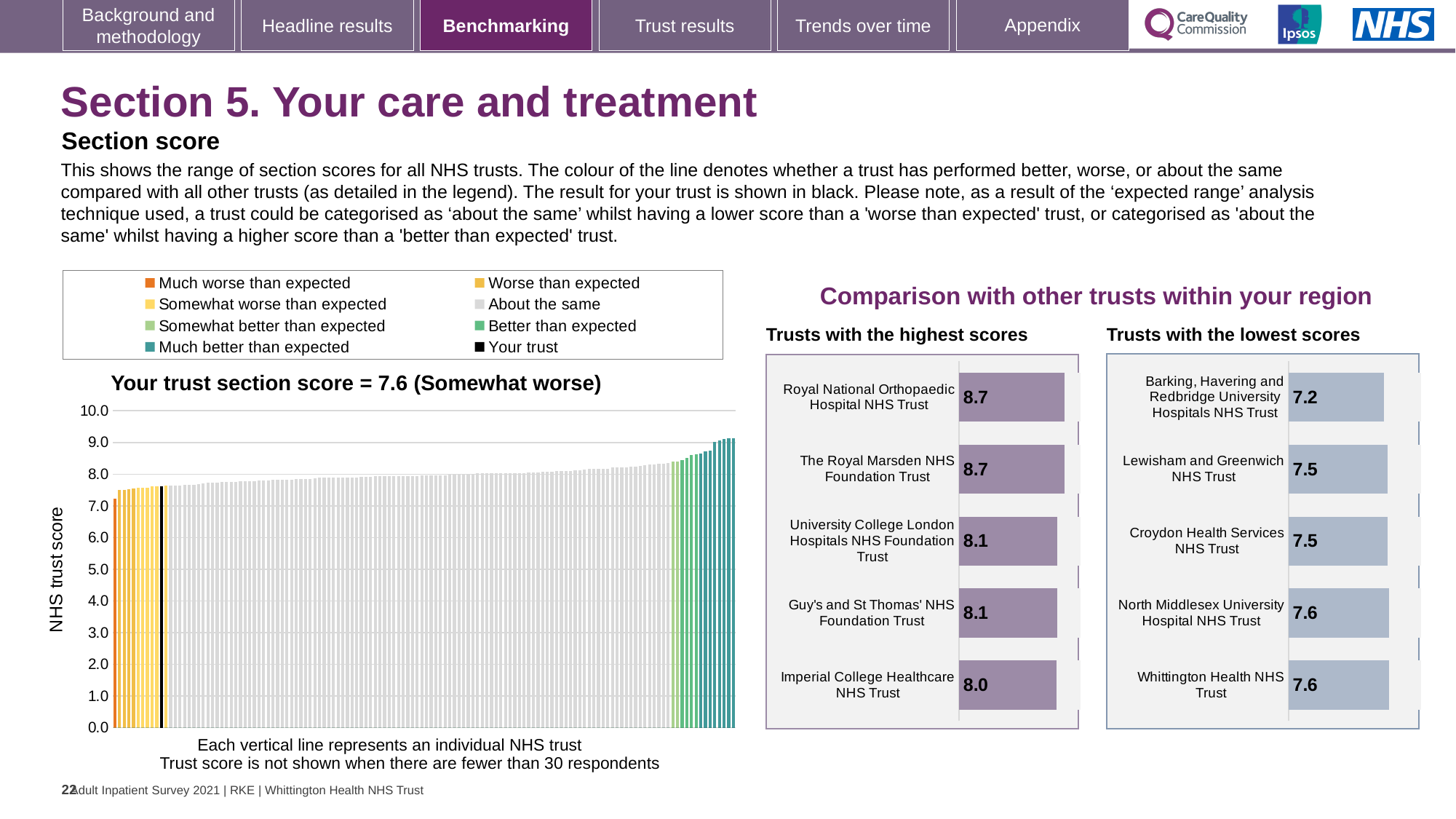
How many entries does the legend above the left-hand chart list? 8 In the 'Trusts with the lowest scores' chart, what is the score for Croydon Health Services NHS Trust? 7.5 How many trusts are shown in the 'Trusts with the highest scores' chart? 5 In the 'Trusts with the lowest scores' chart, which has the higher score: Lewisham and Greenwich NHS Trust or North Middlesex University Hospital NHS Trust? North Middlesex University Hospital NHS Trust In the 'Trusts with the lowest scores' chart, what is the difference between the score for Whittington Health NHS Trust and the score for Barking, Havering and Redbridge University Hospitals NHS Trust? 0.4 In the 'Your trust section score' chart on the left, do the trust scores rise or fall from left to right along the x axis? rise What kind of chart is the 'Your trust section score' chart on the left of the slide? bar chart In the 'Trusts with the lowest scores' chart, what is the score for Barking, Havering and Redbridge University Hospitals NHS Trust? 7.2 In the 'Trusts with the highest scores' chart, what is the score for Imperial College Healthcare NHS Trust? 8.0 In the 'Trusts with the highest scores' chart, what is the difference between the score for Royal National Orthopaedic Hospital NHS Trust and the score for Imperial College Healthcare NHS Trust? 0.7 In the 'Trusts with the lowest scores' chart, which trust has the lowest score? Barking, Havering and Redbridge University Hospitals NHS Trust According to the title of the chart on the left, what is your trust's section score? 7.6